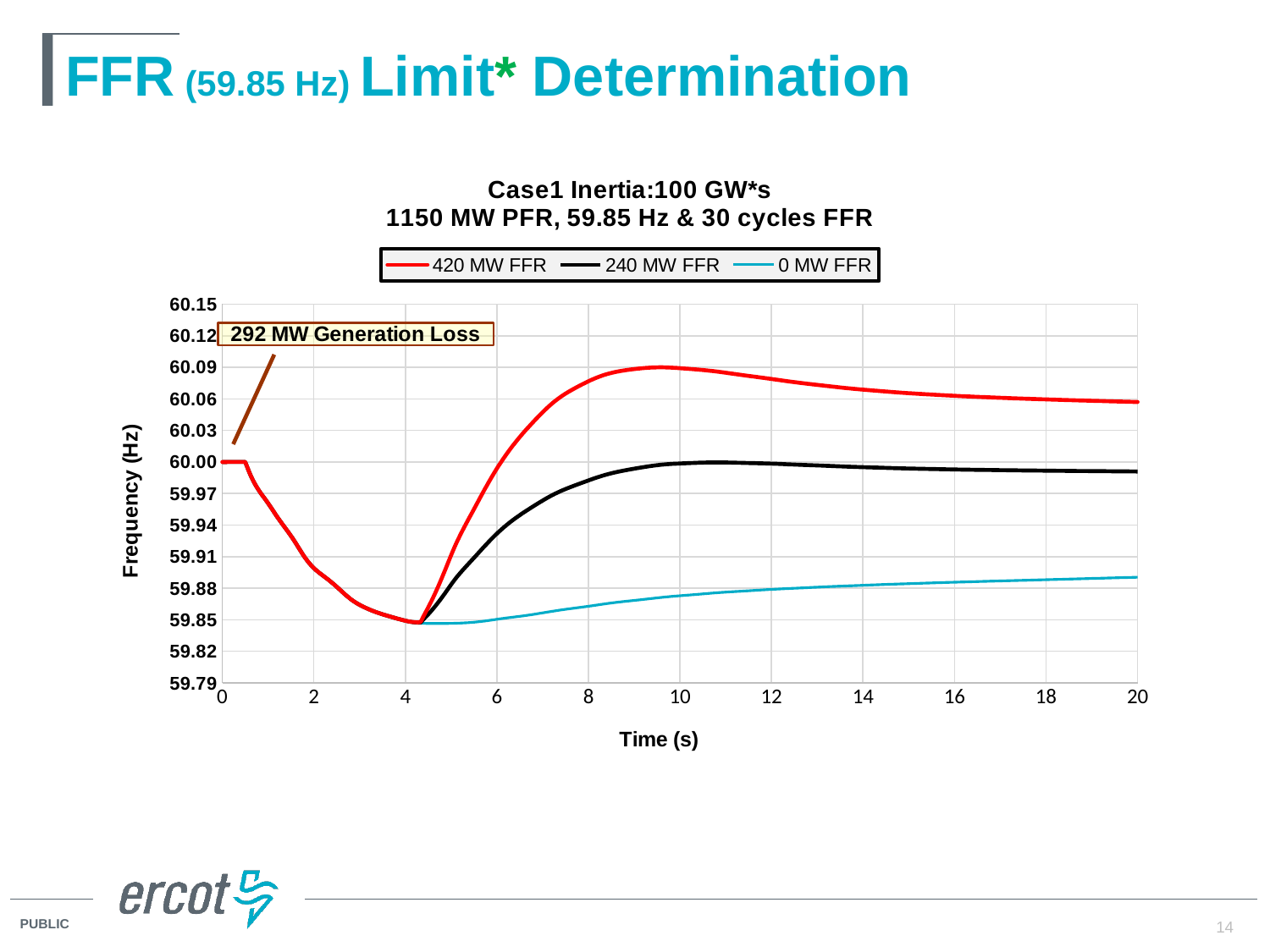
What are the three series named in the legend? 420 MW FFR, 240 MW FFR, 0 MW FFR Is the lowest point of the 420 MW FFR series greater or less than 59.88? less Is the value of the 420 MW FFR series at time 10 s greater or less than 60.06? greater At time 20 s, which series has the higher frequency, 420 MW FFR or 0 MW FFR? 420 MW FFR Does the 420 MW FFR series rise or fall between time 10 s and time 20 s? fall How many series does the legend list? 3 Is the value of the 240 MW FFR series at time 20 s greater or less than 60.03? less What kind of chart is shown on the slide? line chart At time 8 s, which series has the higher frequency, 240 MW FFR or 0 MW FFR? 240 MW FFR What text appears in the annotation box near the top left of the plot area? 292 MW Generation Loss Does the 0 MW FFR series rise or fall between time 6 s and time 20 s? rise